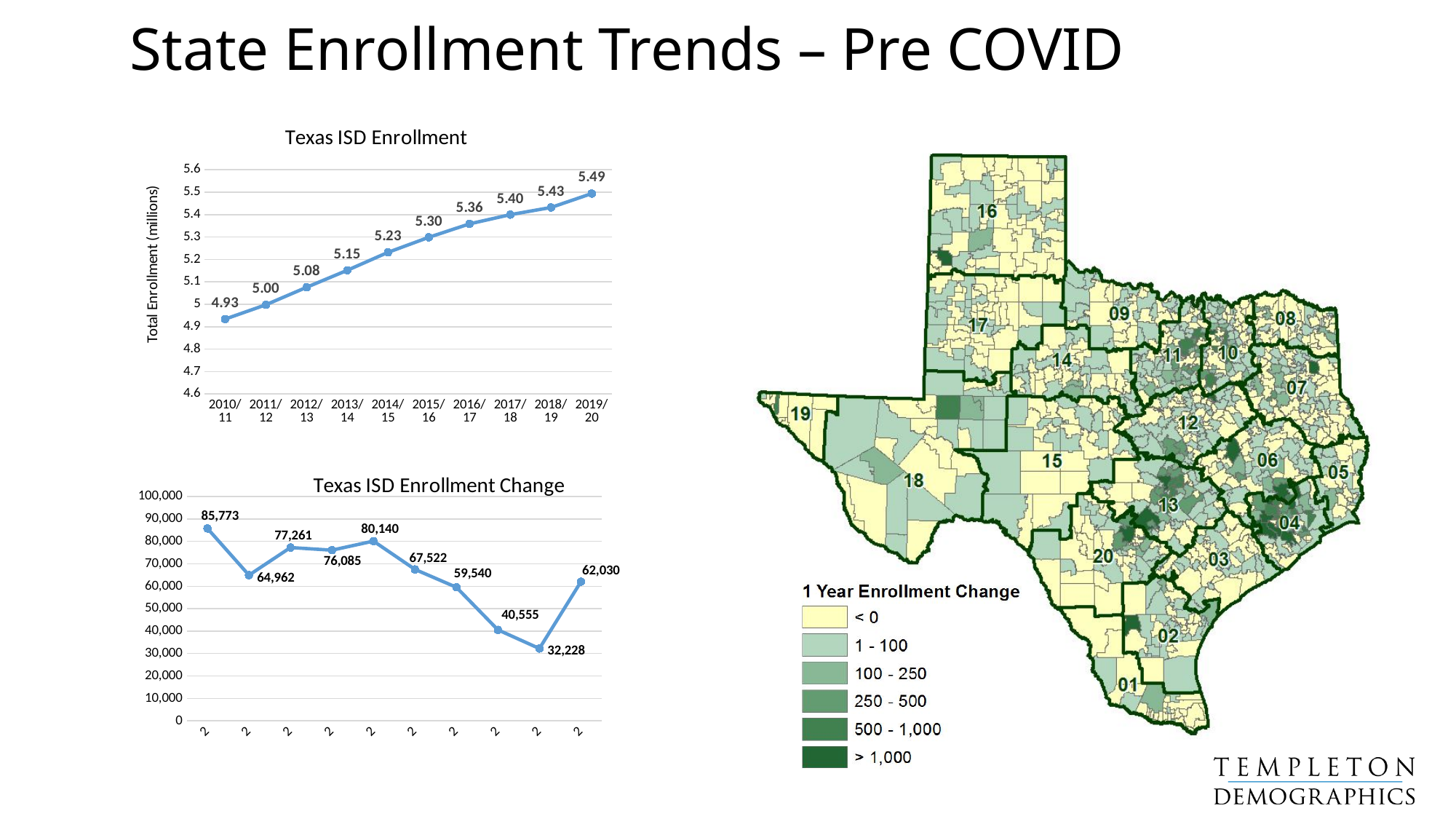
In the Texas ISD Enrollment chart, which school year has the lowest enrollment? 2010/11 In the Texas ISD Enrollment Change chart, what is the lowest value shown? 32,228 In the Texas ISD Enrollment chart, what is the value for 2015/16? 5.30 In the Texas ISD Enrollment chart, what is the total enrollment (millions) for 2010/11? 4.93 In the Texas ISD Enrollment chart, which school year has the highest enrollment? 2019/20 In the Texas ISD Enrollment Change chart, what is the highest value shown? 85,773 In the Texas ISD Enrollment chart, what is the difference in enrollment (millions) between 2019/20 and 2010/11? 0.56 What kind of chart is the Texas ISD Enrollment chart? line chart In the Texas ISD Enrollment chart, do the values rise or fall from 2010/11 to 2019/20? rise How many school years are plotted in the Texas ISD Enrollment chart? 10 In the Texas ISD Enrollment chart, what is the total enrollment (millions) for 2019/20? 5.49 In the Texas ISD Enrollment Change chart, what is the value of the last data point on the right? 62,030